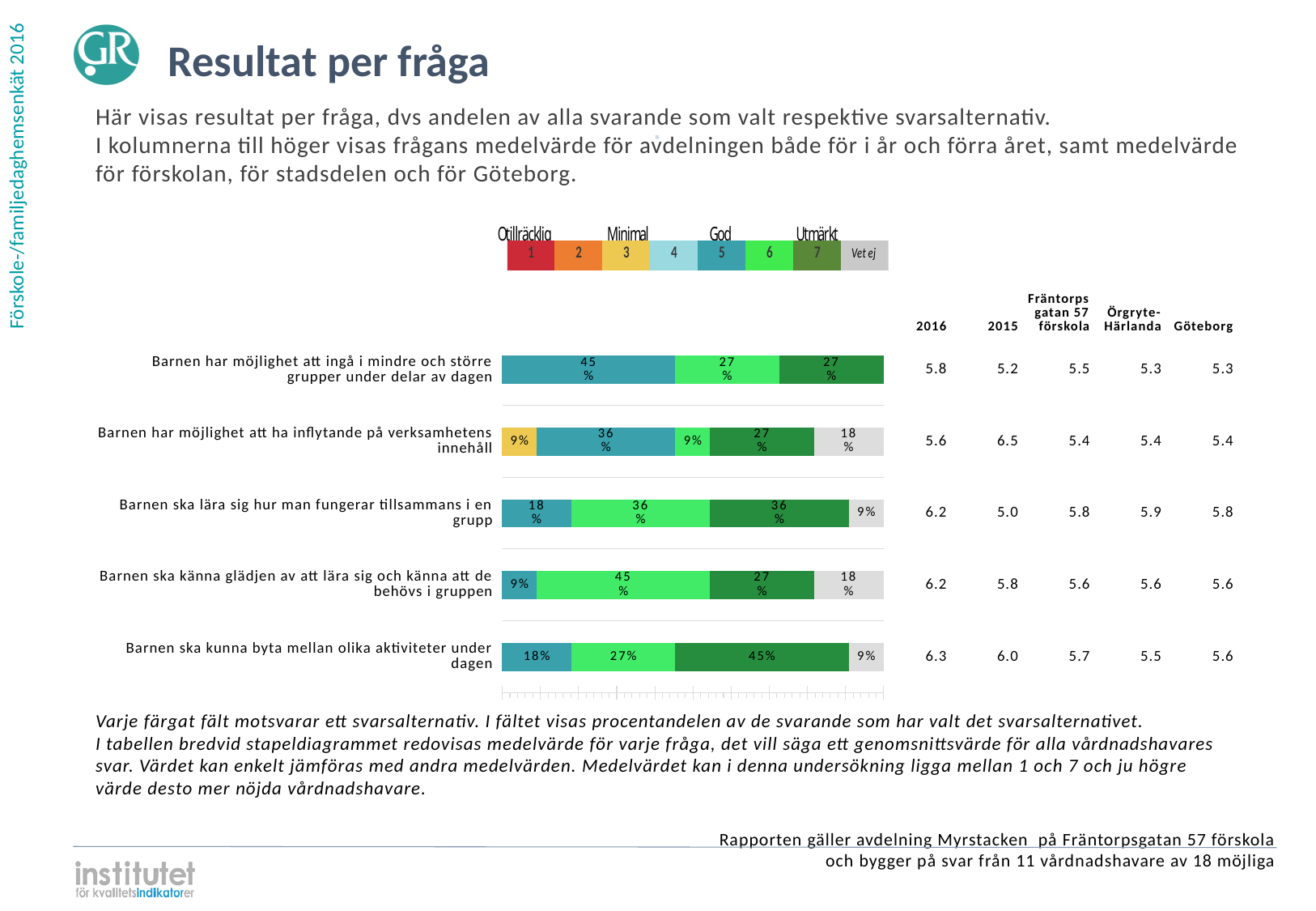
What percentage of respondents chose answer 7 (dark green) for 'Barnen ska kunna byta mellan olika aktiviteter under dagen'? 45% What share of respondents answered 'Vet ej' for 'Barnen har möjlighet att ha inflytande på verksamhetens innehåll'? 18% What percentage chose answer 6 (light green) for 'Barnen ska känna glädjen av att lära sig och känna att de behövs i gruppen'? 45% What percentage of respondents chose answer 5 (teal) for 'Barnen har möjlighet att ingå i mindre och större grupper under delar av dagen'? 45% What is the difference between the share of answer 7 and the share of answer 5 for 'Barnen ska kunna byta mellan olika aktiviteter under dagen'? 27% How many questions (bars) are shown in the chart? 5 For 'Barnen ska lära sig hur man fungerar tillsammans i en grupp', is the share of answer 6 larger or smaller than the share of answer 5? Larger How many answer categories does the legend above the chart list, including 'Vet ej'? 8 Which question is the only one with a yellow (answer 3) segment? Barnen har möjlighet att ha inflytande på verksamhetens innehåll Which question has the largest share of answer 7 (dark green)? Barnen ska kunna byta mellan olika aktiviteter under dagen What is the 2016 mean value shown for 'Barnen ska kunna byta mellan olika aktiviteter under dagen'? 6.3 What kind of chart is used to show the distribution of answers per question? Stacked bar chart